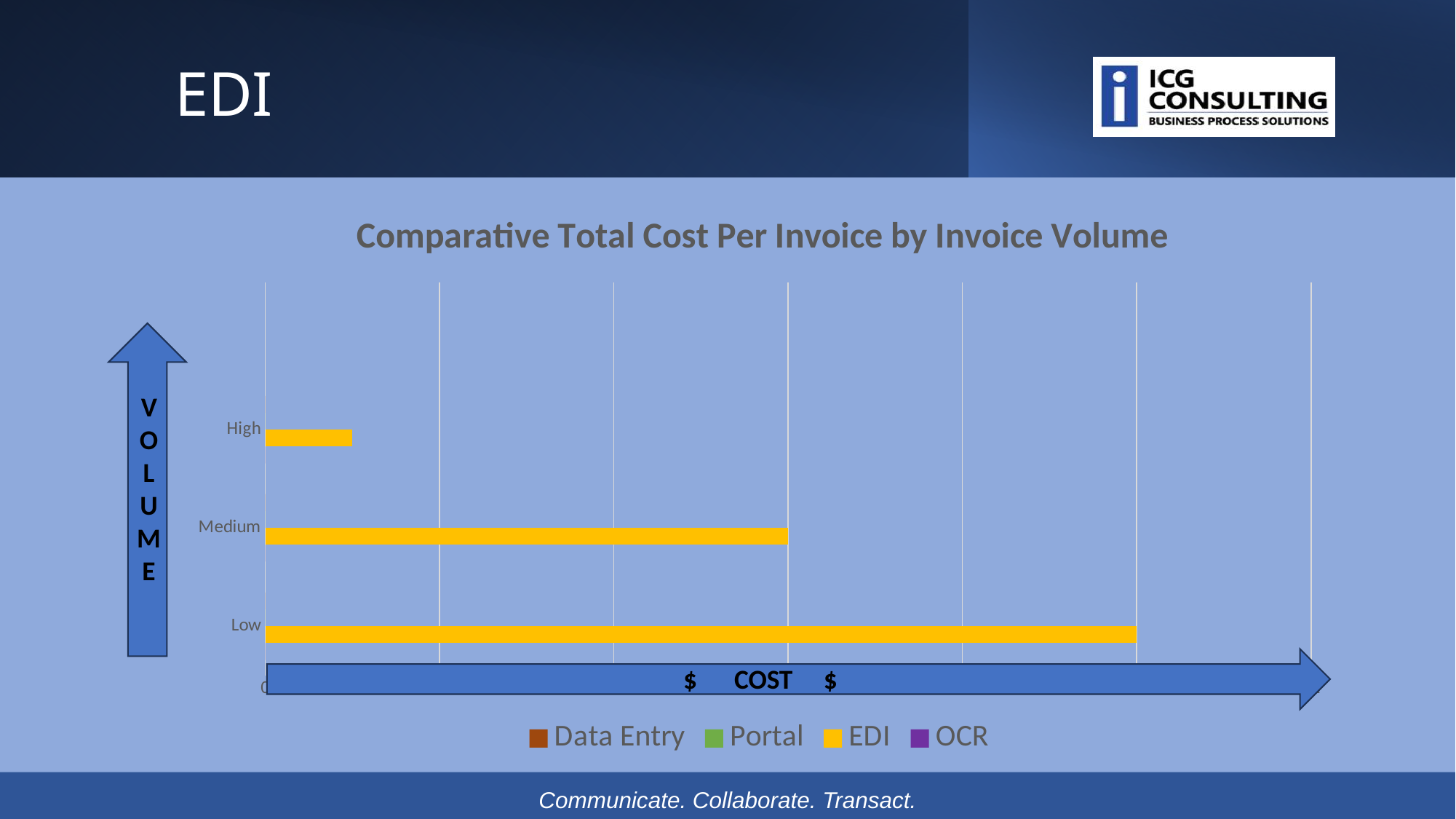
Does the EDI cost per invoice rise or fall as invoice volume goes from Low to High? fall Which volume category has the shortest EDI bar? High How many volume categories are shown on the chart's vertical axis? 3 How many series does the chart legend list? 4 Is the EDI bar for Medium volume longer or shorter than the EDI bar for High volume? longer Which series is the only one with visible bars on the chart? EDI What kind of chart is shown on the slide? bar chart Which volume category has the longest EDI bar? Low Is the EDI bar for Low volume longer or shorter than the EDI bar for Medium volume? longer Which series are listed in the chart legend? Data Entry, Portal, EDI, OCR What is the title of the chart? Comparative Total Cost Per Invoice by Invoice Volume